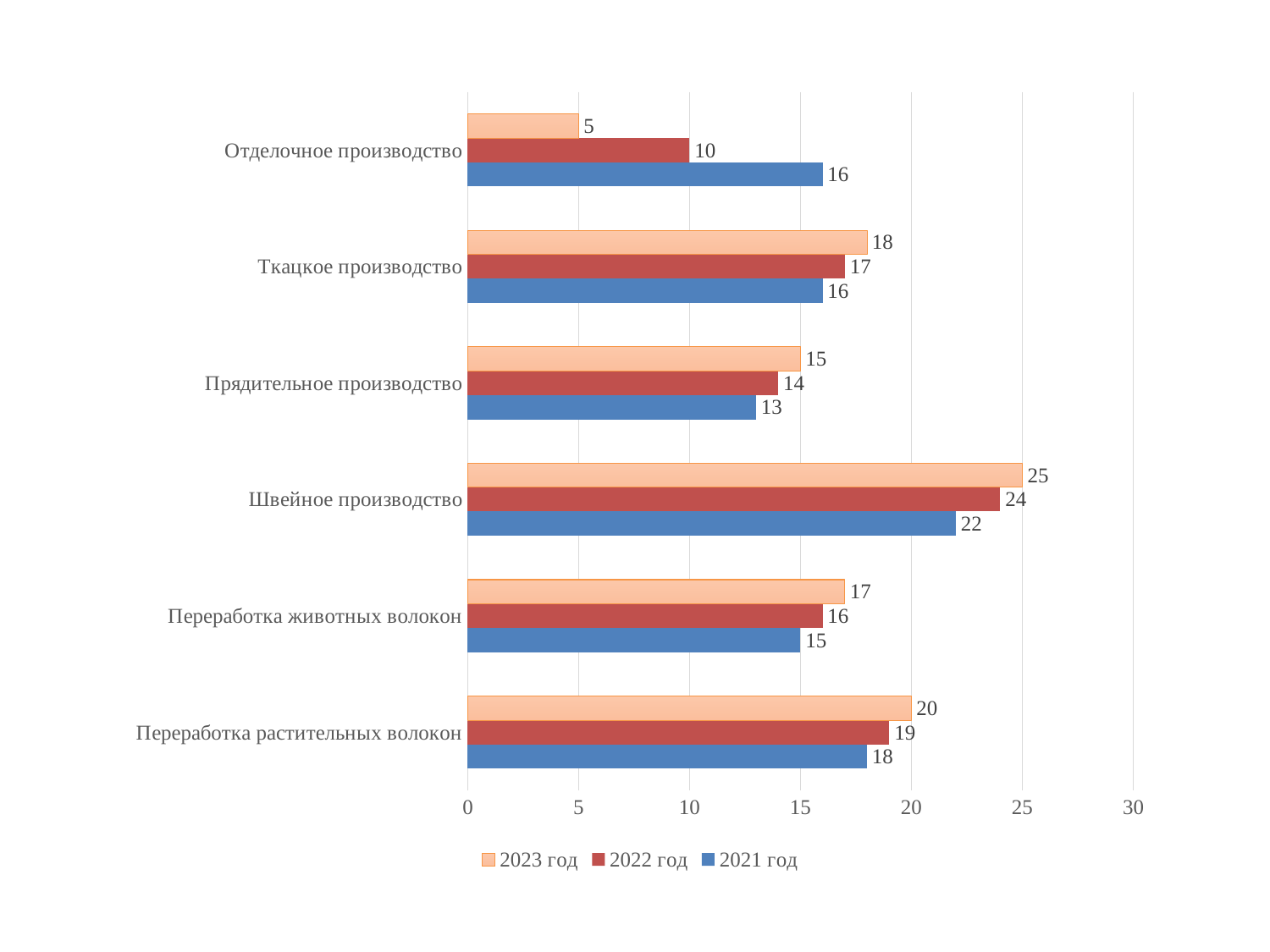
What is the difference between the 2023 год values for Швейное производство and Прядительное производство? 10 How many categories are shown on the chart? 6 Which series is shown in blue in the legend? 2021 год Which is larger for Ткацкое производство: the 2023 год value or the 2021 год value? 2023 год What kind of chart is shown on the slide? Bar chart What is the value for Переработка растительных волокон in 2022 год? 19 Which category has the highest value in 2023 год? Швейное производство What is the value for Швейное производство in 2023 год? 25 What is the value for Отделочное производство in 2021 год? 16 Which category has the lowest value in 2023 год? Отделочное производство How many series does the legend list? 3 What is the difference between the 2021 год and 2023 год values for Отделочное производство? 11